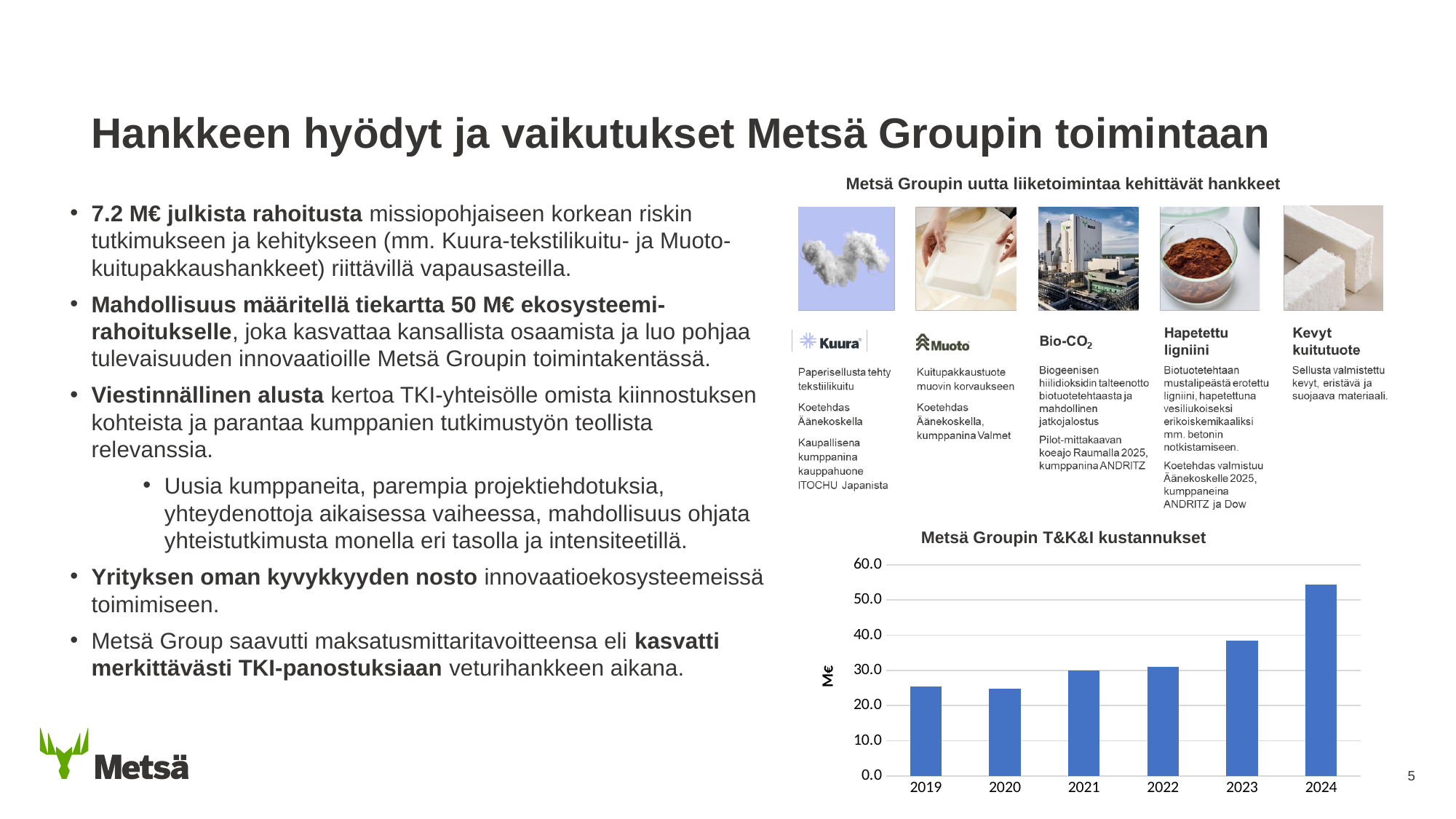
In the "Metsä Groupin T&K&I kustannukset" chart, is the value for 2024 greater or less than 50.0? greater In the "Metsä Groupin T&K&I kustannukset" chart, is the value for 2023 greater or less than 40.0? less In the "Metsä Groupin T&K&I kustannukset" chart, is the value for 2019 greater or less than 20.0? greater What kind of chart is "Metsä Groupin T&K&I kustannukset"? bar chart In the "Metsä Groupin T&K&I kustannukset" chart, do the values generally rise or fall from 2020 to 2024? rise What unit is shown on the y axis of the "Metsä Groupin T&K&I kustannukset" chart? M€ In the "Metsä Groupin T&K&I kustannukset" chart, which is larger, the value for 2021 or the value for 2024? 2024 In the "Metsä Groupin T&K&I kustannukset" chart, which year has the highest value? 2024 In the "Metsä Groupin T&K&I kustannukset" chart, which is larger, the value for 2023 or the value for 2022? 2023 How many years are shown on the x axis of the "Metsä Groupin T&K&I kustannukset" chart? 6